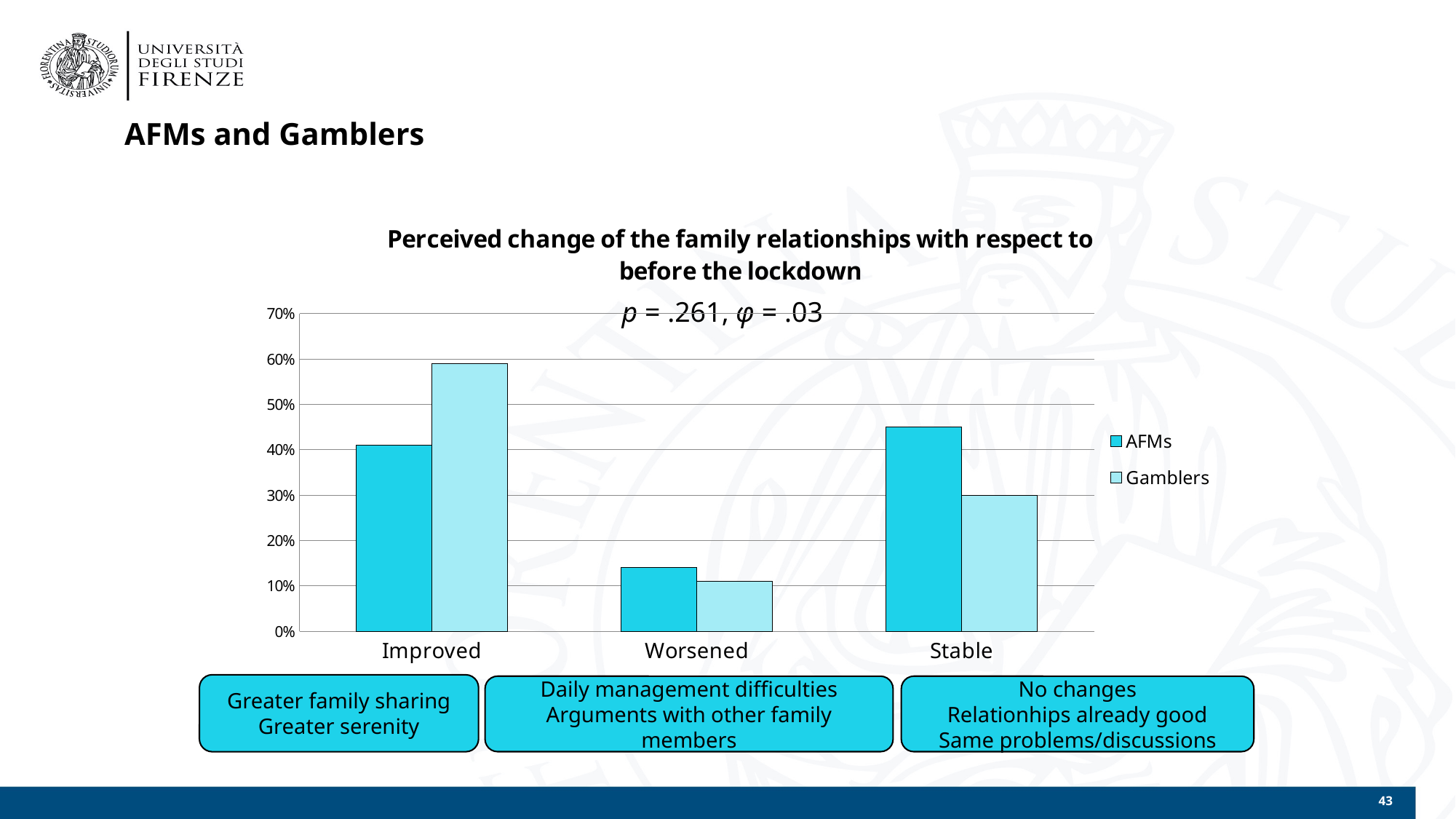
Which category has the highest value for AFMs? Stable Is the value for AFMs in the Worsened category greater or less than 20%? less Which category has the lowest value for AFMs? Worsened Which category has the highest value for Gamblers? Improved What is the title of the chart? Perceived change of the family relationships with respect to before the lockdown How many series does the legend list? 2 Is the value for Gamblers in the Improved category greater or less than 50%? greater For the Stable category, which series has the larger value, AFMs or Gamblers? AFMs Is the value for Gamblers in the Stable category greater or less than 40%? less What kind of chart is shown on the slide? bar chart How many categories are shown on the x axis? 3 For the Improved category, which series has the larger value, AFMs or Gamblers? Gamblers